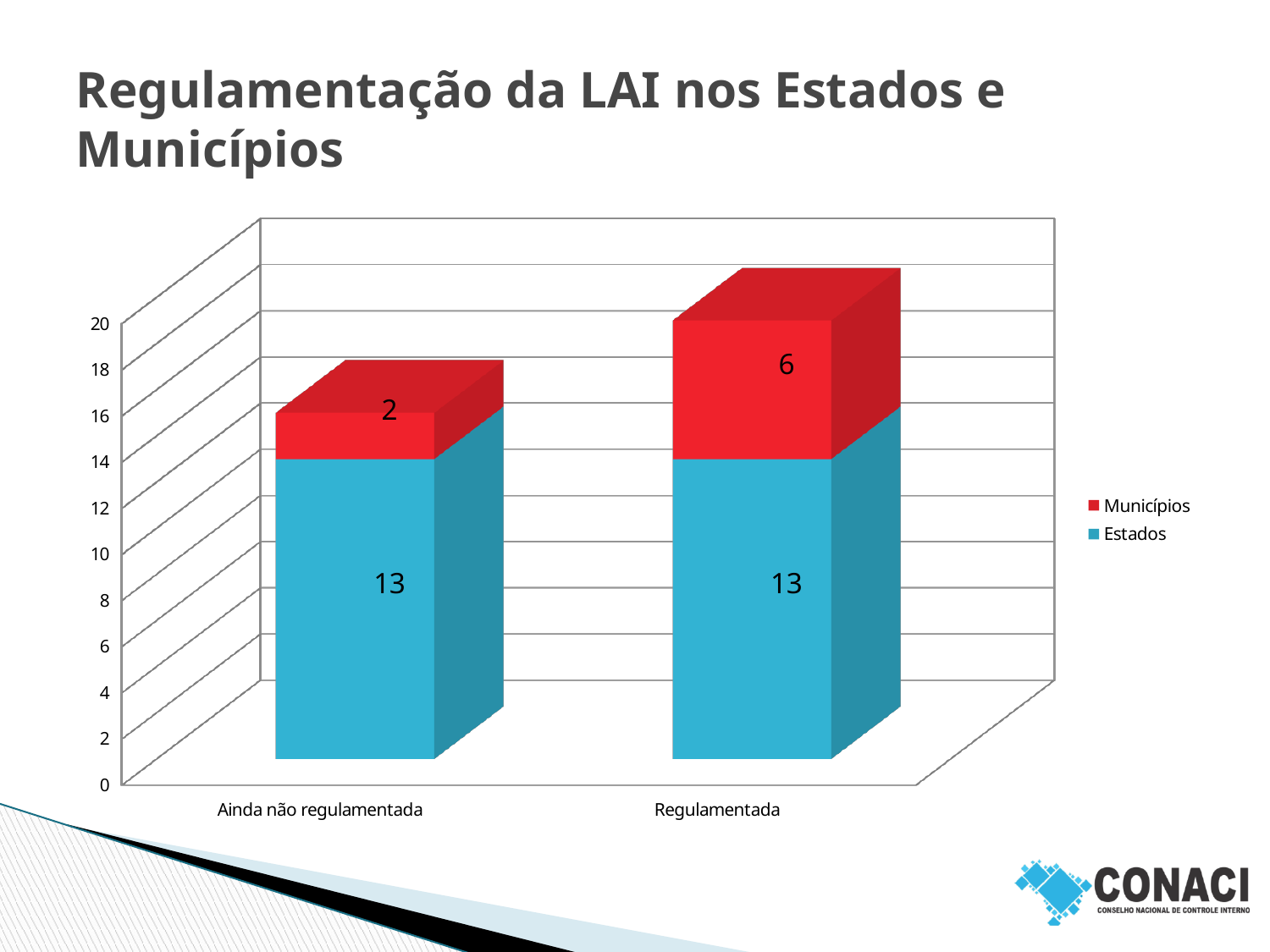
How many categories are shown on the x axis? 2 What is the value for Estados in the 'Regulamentada' category? 13 What is the value for Estados in the 'Ainda não regulamentada' category? 13 What is the value for Municípios in the 'Regulamentada' category? 6 What kind of chart is shown on the slide? stacked bar chart What is the total of the stacked bar for 'Regulamentada'? 19 What is the value for Municípios in the 'Ainda não regulamentada' category? 2 How many series does the legend list? 2 What is the total of the stacked bar for 'Ainda não regulamentada'? 15 Which category has the higher value for Municípios? Regulamentada What is the difference between the Municípios values for 'Regulamentada' and 'Ainda não regulamentada'? 4 Is the Municípios value for 'Regulamentada' larger or smaller than the Municípios value for 'Ainda não regulamentada'? larger